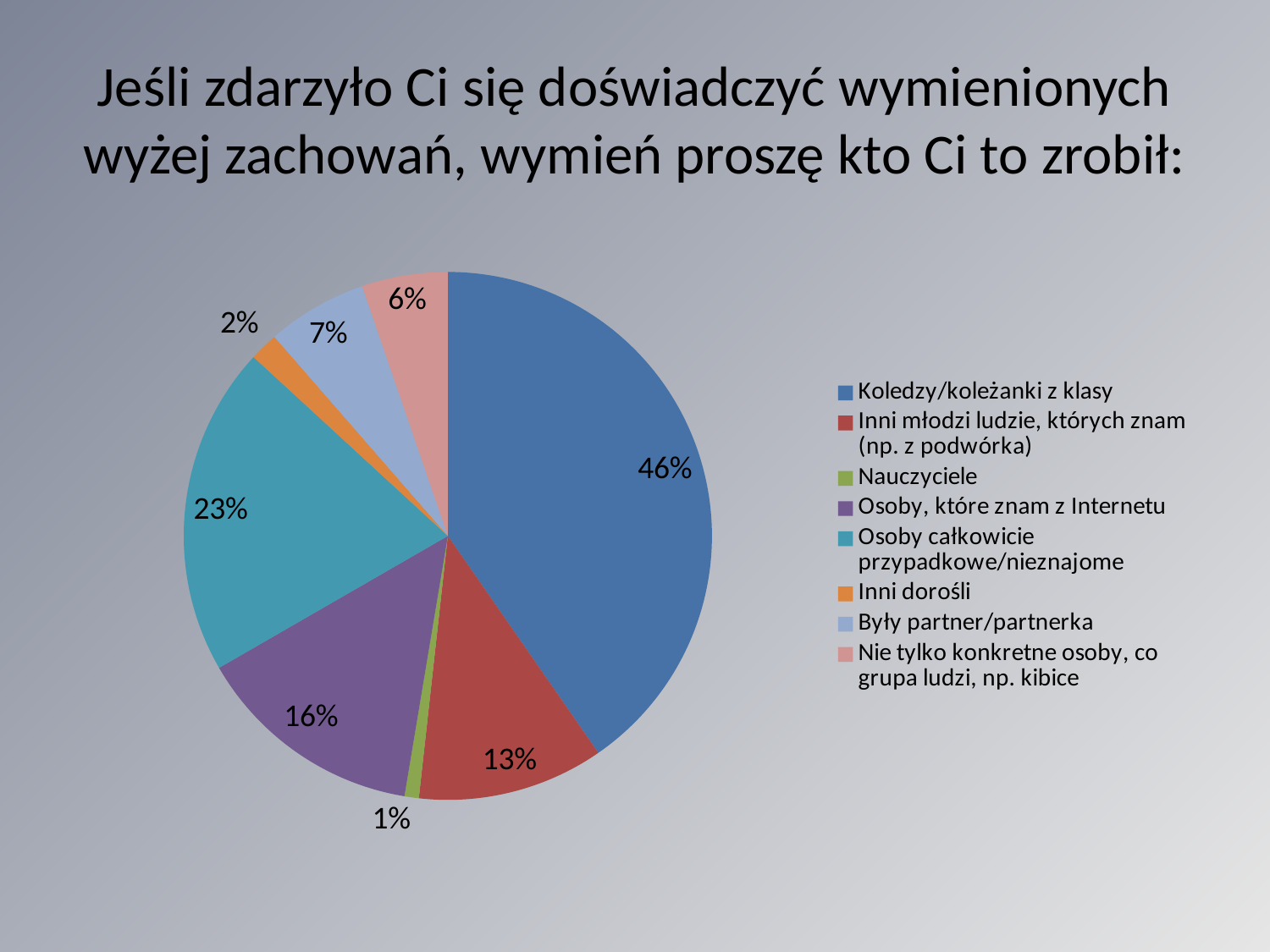
Which category has the smallest share of the pie? Nauczyciele What percentage is shown for Osoby całkowicie przypadkowe/nieznajome? 23% What is the difference in percentage points between Koledzy/koleżanki z klasy and Osoby całkowicie przypadkowe/nieznajome? 23 What colour is the slice for Inni dorośli? orange How many slices does the pie chart have? 8 How many entries does the legend list? 8 What percentage of the pie is labelled for Koledzy/koleżanki z klasy? 46% Which is larger: the share for Inni młodzi ludzie, których znam (np. z podwórka) or the share for Osoby, które znam z Internetu? Osoby, które znam z Internetu What percentage is shown for Osoby, które znam z Internetu? 16% Which category has the largest share of the pie? Koledzy/koleżanki z klasy What percentage is shown for Były partner/partnerka? 7% What kind of chart is shown on the slide? pie chart